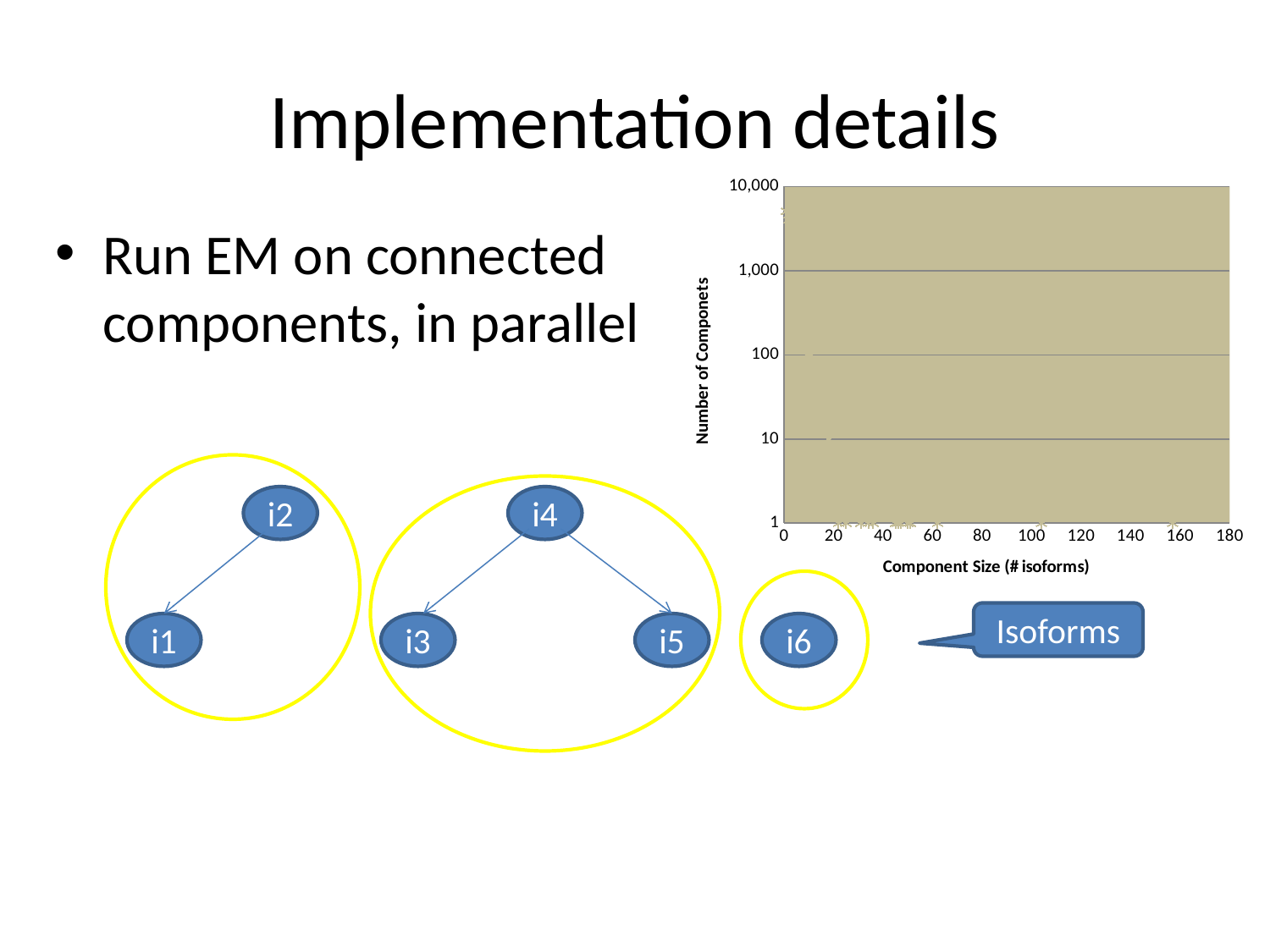
What is the label of the y axis of the chart? Number of Components Is the number of components for the smallest component sizes greater or less than 1,000? greater What is the highest value shown on the x axis of the chart? 180 What is the label of the x axis of the chart? Component Size (# isoforms) Is the number of components for component sizes above 100 greater or less than 10? less What is the highest value shown on the y axis of the chart? 10,000 What kind of chart is shown on the slide? scatter plot Does the number of components rise or fall as component size increases along the x axis? fall